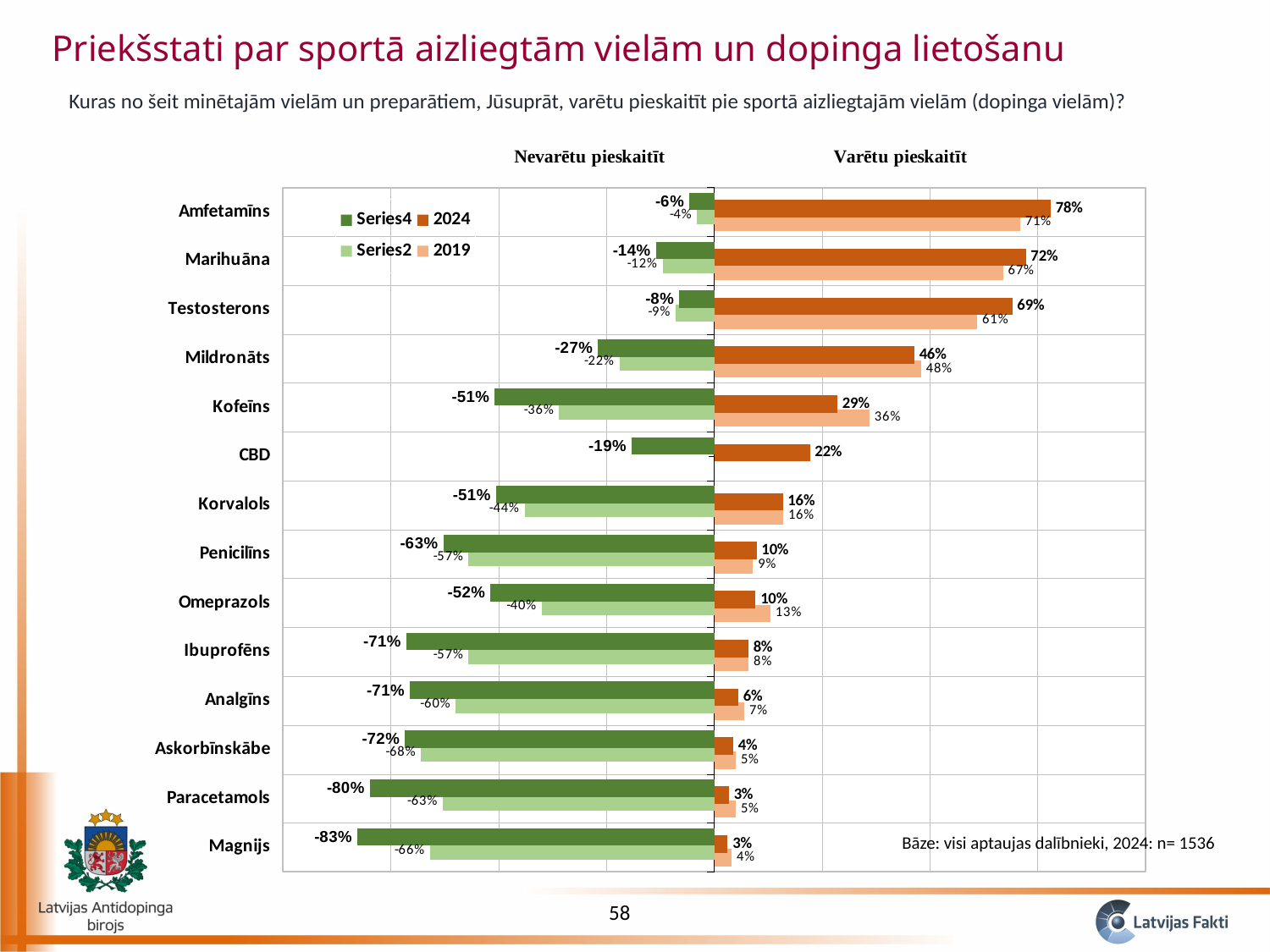
What is the difference between the 2024 and 2019 'Varētu pieskaitīt' values for Amfetamīns? 7 percentage points How many substances are listed on the chart? 14 Which substance has the highest 2024 'Varētu pieskaitīt' value? Amfetamīns What is the 2019 'Varētu pieskaitīt' value for Kofeīns? 36% Which substance has no 2019 values shown on the chart? CBD For Mildronāts, which is larger: the 2024 or the 2019 'Varētu pieskaitīt' value? 2019 Which substance has the lowest 2019 'Varētu pieskaitīt' value? Magnijs What is the 2019 'Varētu pieskaitīt' value for Testosterons? 61% What is the 2024 'Varētu pieskaitīt' value for Amfetamīns? 78% What kind of chart is shown on the slide? Bar chart How many series does the legend list? 4 What is the 2024 'Nevarētu pieskaitīt' value for Magnijs? -83%